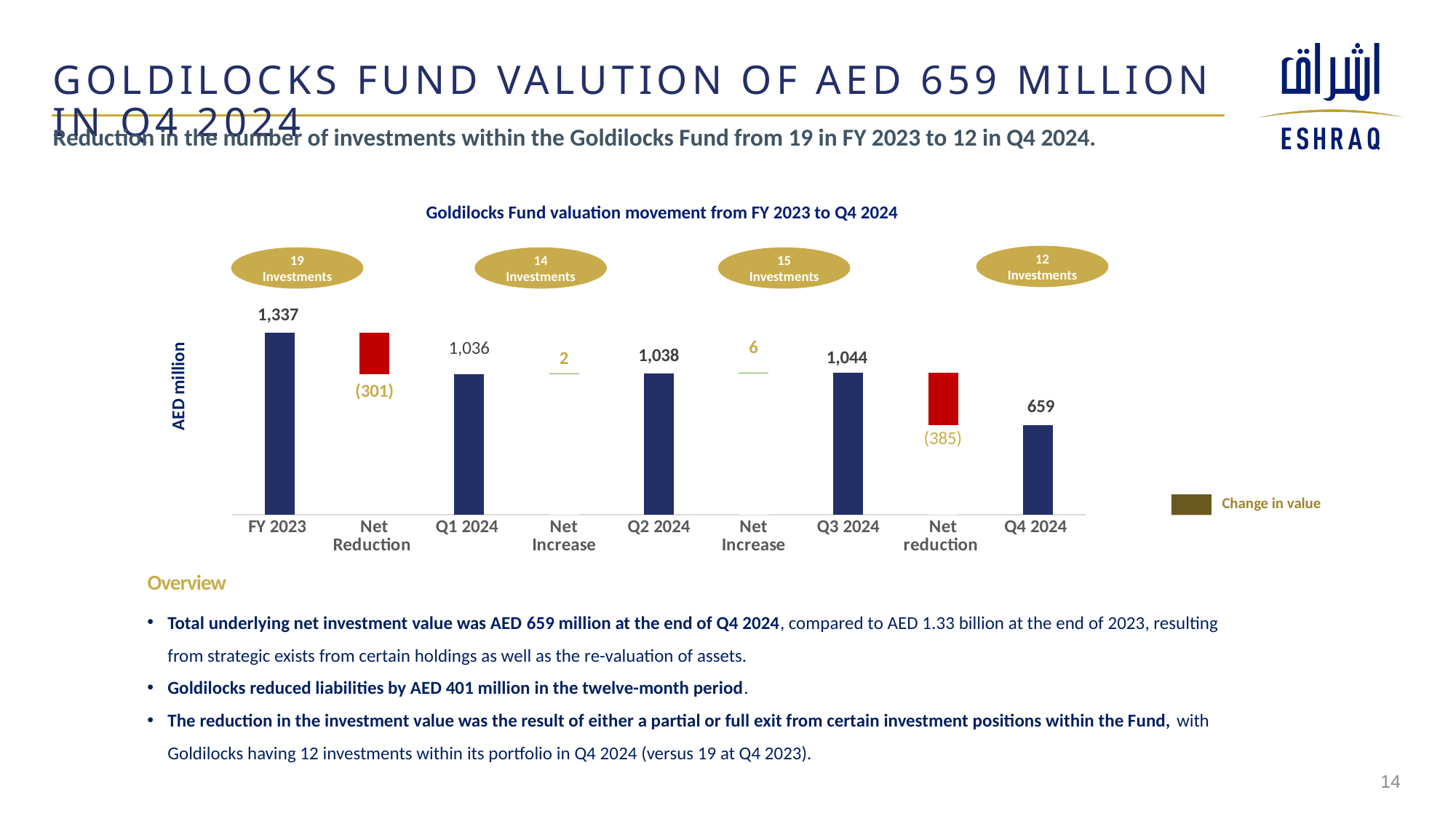
What is the difference between the FY 2023 valuation and the Q4 2024 valuation? 678 What is the value of the Net Reduction bar between FY 2023 and Q1 2024? (301) Does the fund valuation rise or fall from FY 2023 to Q4 2024? fall What is the value of the Net reduction bar between Q3 2024 and Q4 2024? (385) What is the Goldilocks Fund valuation for Q4 2024 in the chart? 659 What is the Goldilocks Fund valuation for FY 2023 in the chart? 1,337 What is the valuation shown for Q3 2024? 1,044 Which period has the highest valuation in the chart? FY 2023 Which period has the lowest valuation in the chart? Q4 2024 What is the label on the vertical axis of the chart? AED million Which is larger, the valuation for Q2 2024 or for Q3 2024? Q3 2024 How many categories are shown along the x axis of the chart? 9